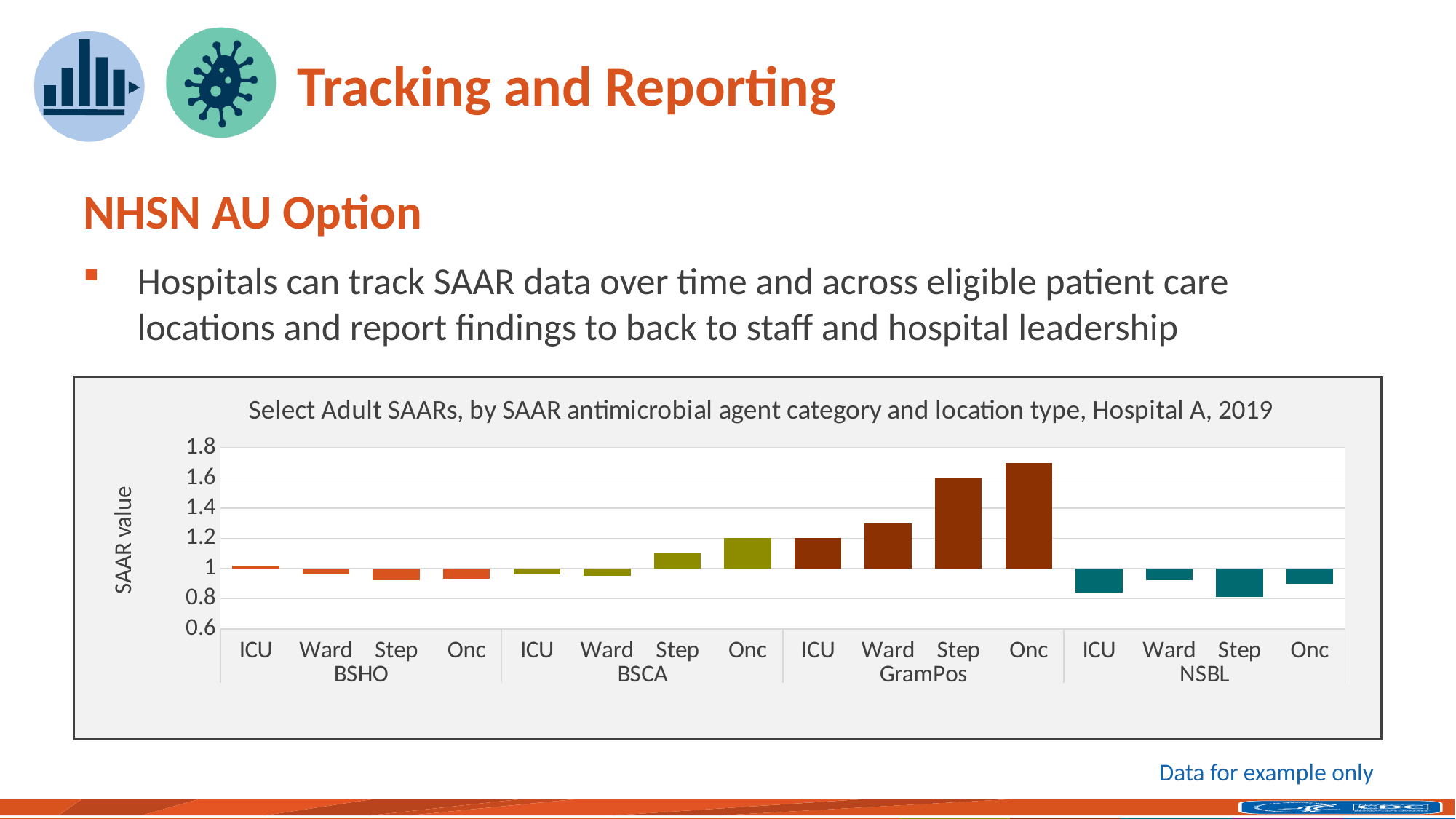
What kind of chart is shown on the slide? bar chart What is the label on the vertical axis of the chart? SAAR value How many antimicrobial agent categories are shown along the x axis? 4 Within the GramPos category, do the SAAR values rise or fall from ICU to Onc? rise Is the SAAR value for Step in NSBL greater or less than 1? less Is the SAAR value for Ward in GramPos greater or less than 1.2? greater Is the SAAR value for Onc in GramPos greater or less than 1.6? greater How many bars are plotted in the chart? 16 Which is larger, the SAAR value for Step in GramPos or Step in BSCA? Step in GramPos What is the title of the chart? Select Adult SAARs, by SAAR antimicrobial agent category and location type, Hospital A, 2019 Which location in which category has the highest SAAR value? Onc in GramPos